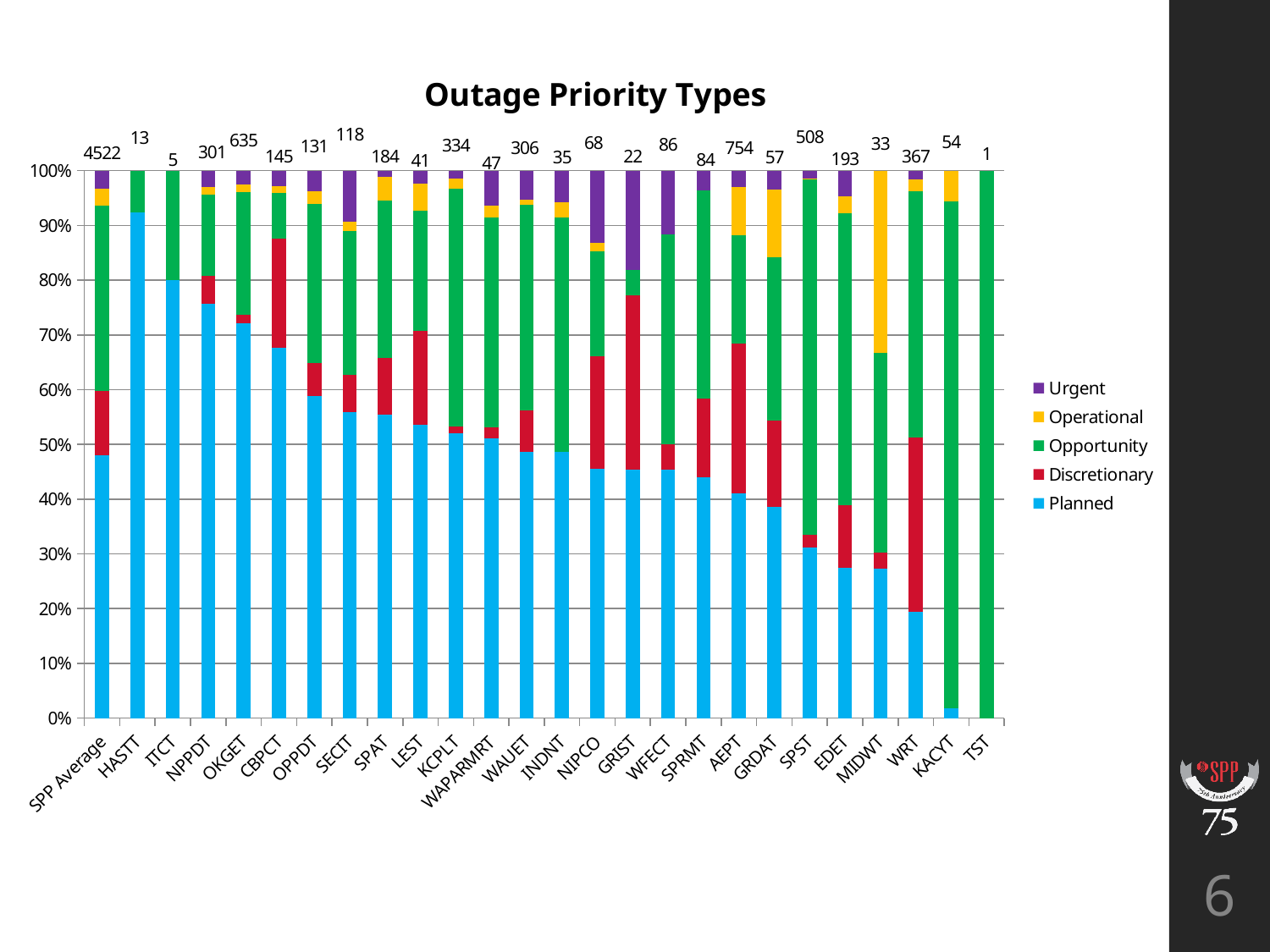
Is the Planned share for ITCT greater or less than 70%? greater What is the difference between the numbers printed above the bars for OKGET and NPPDT? 334 What type of chart is shown on the slide? stacked bar chart What number is printed above the bar for AEPT? 754 Is the Planned share for KACYT greater or less than 10%? less What number is printed above the bar for SPP Average? 4522 How many series does the legend list? 5 What number is printed above the bar for GRIST? 22 Which has the larger number printed above its bar, OKGET or NPPDT? OKGET Excluding SPP Average, which category has the largest number printed above its bar? AEPT How many categories are shown along the x axis? 26 Which category has the smallest number printed above its bar? TST